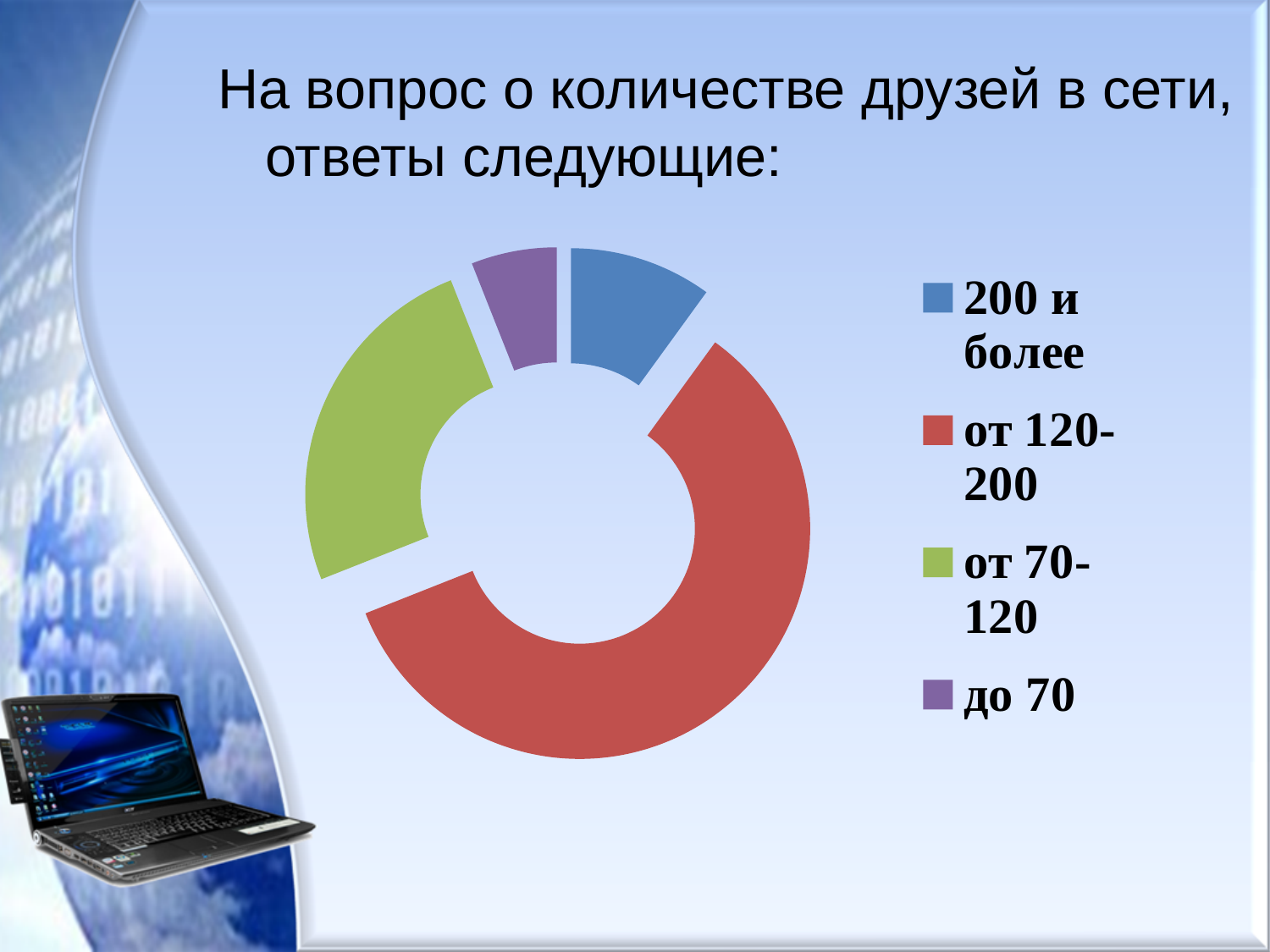
What kind of chart is shown on the slide? doughnut chart How many categories does the chart show? 4 Which category has the larger share: от 70-120 or до 70? от 70-120 Which category has the largest share of the chart? от 120-200 Which category is shown in purple in the chart? до 70 Which category has the larger share: от 70-120 or 200 и более? от 70-120 Which category has the larger share: 200 и более or до 70? 200 и более Which category has the smallest share of the chart? до 70 What colour represents the category от 120-200 in the chart? red